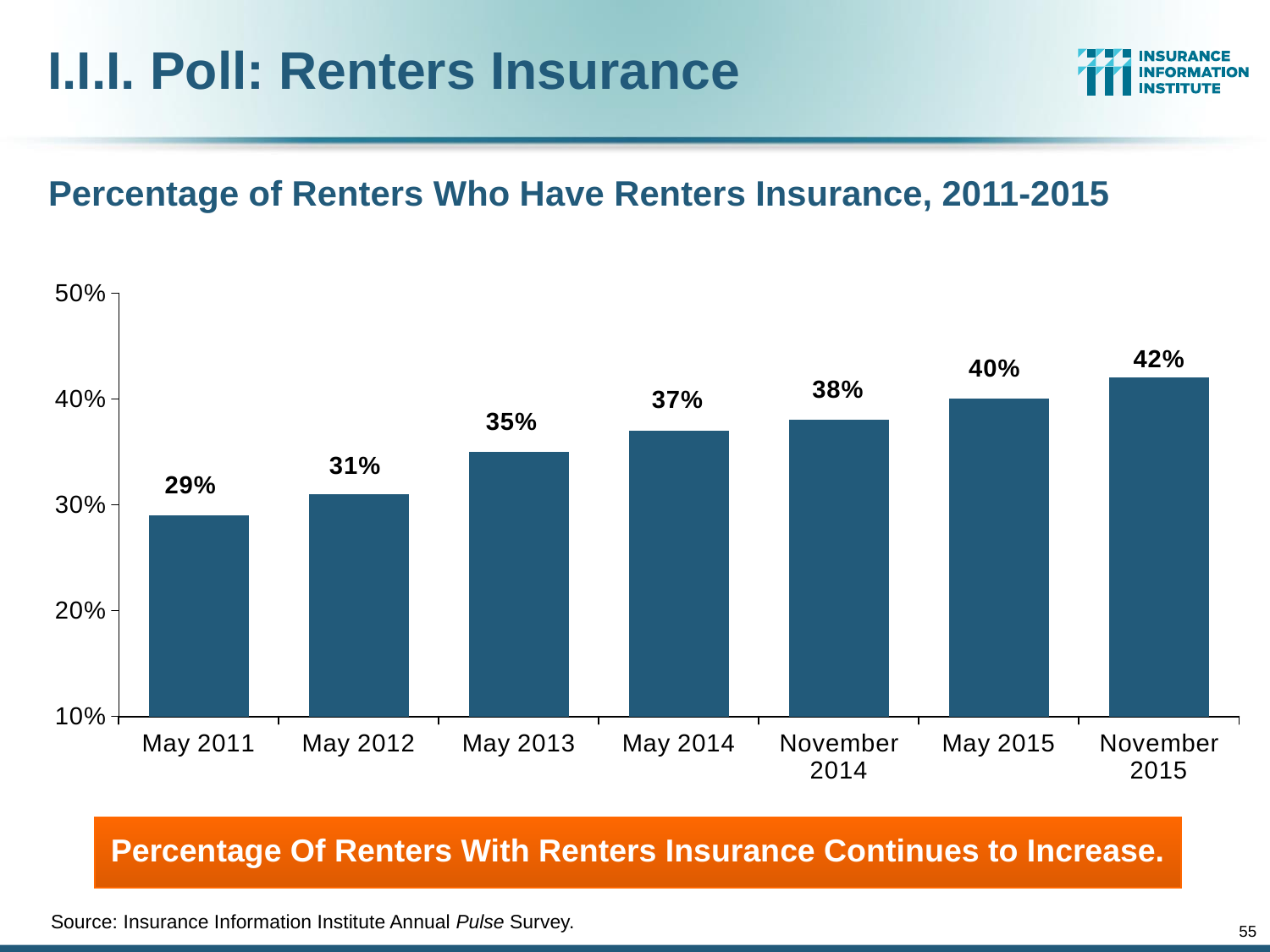
Which period has the highest percentage of renters with renters insurance? November 2015 What kind of chart is shown on the slide? Bar chart What is the title of the chart? Percentage of Renters Who Have Renters Insurance, 2011-2015 Which period has the lowest percentage of renters with renters insurance? May 2011 How many periods are shown on the x axis? 7 What is the difference between the values for November 2015 and May 2011? 13% What percentage of renters had renters insurance in May 2011? 29% What is the value shown for November 2014? 38% Which is larger, the value for May 2014 or the value for May 2012? May 2014 What is the difference between the values for May 2013 and May 2012? 4% Do the values rise or fall from May 2011 to November 2015? Rise What is the value shown for May 2015? 40%